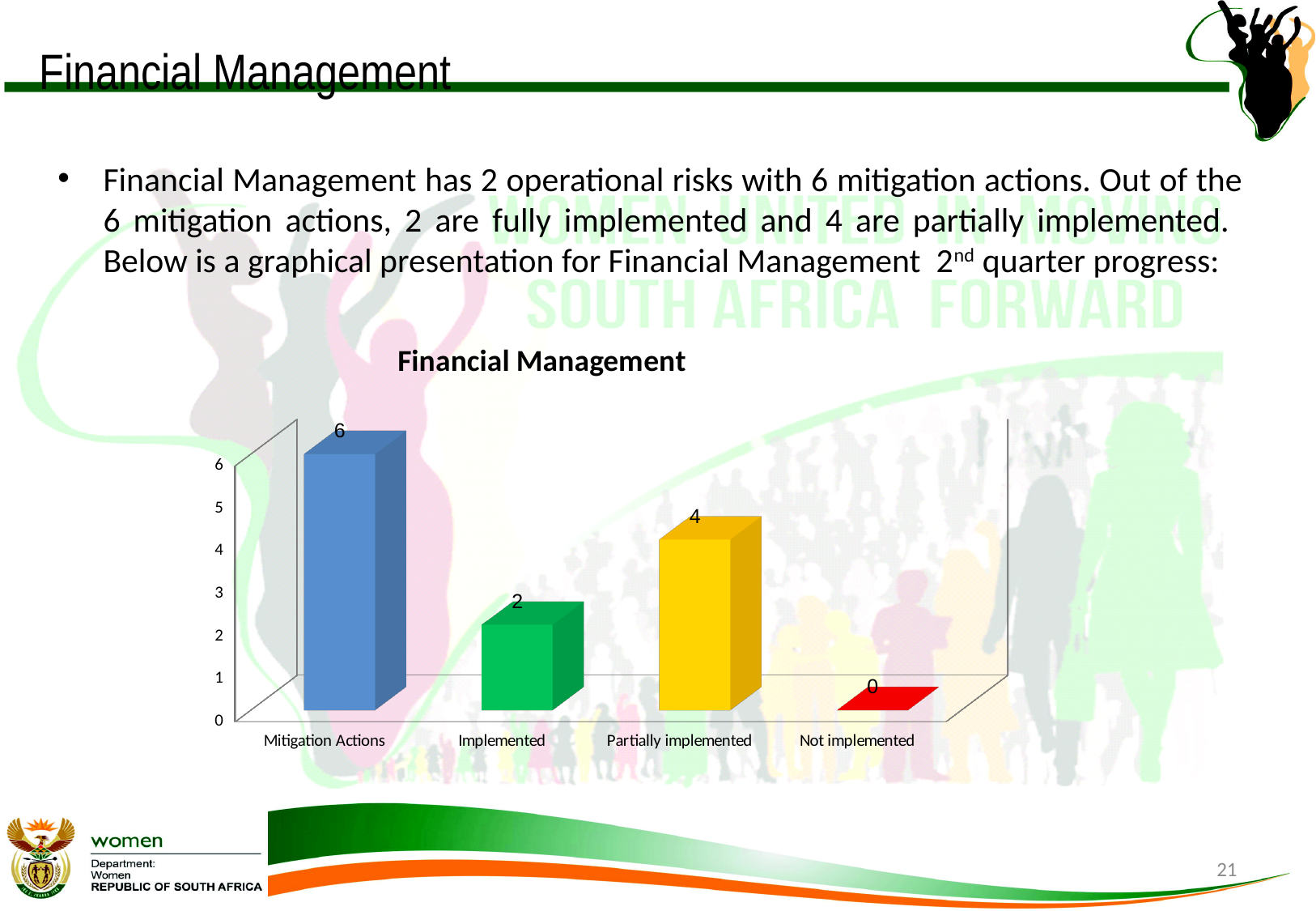
What is the value for Partially implemented? 4 What is the value for Mitigation Actions? 6 Which category has the highest value? Mitigation Actions What is the difference between the values for Mitigation Actions and Partially implemented? 2 What is the value for Implemented? 2 What is the title of the chart? Financial Management What is the value for Not implemented? 0 What is the difference between the values for Partially implemented and Implemented? 2 Which is larger, the value for Implemented or the value for Partially implemented? Partially implemented Which category has the lowest value? Not implemented How many categories are shown on the x axis? 4 What kind of chart is shown on the slide? Bar chart